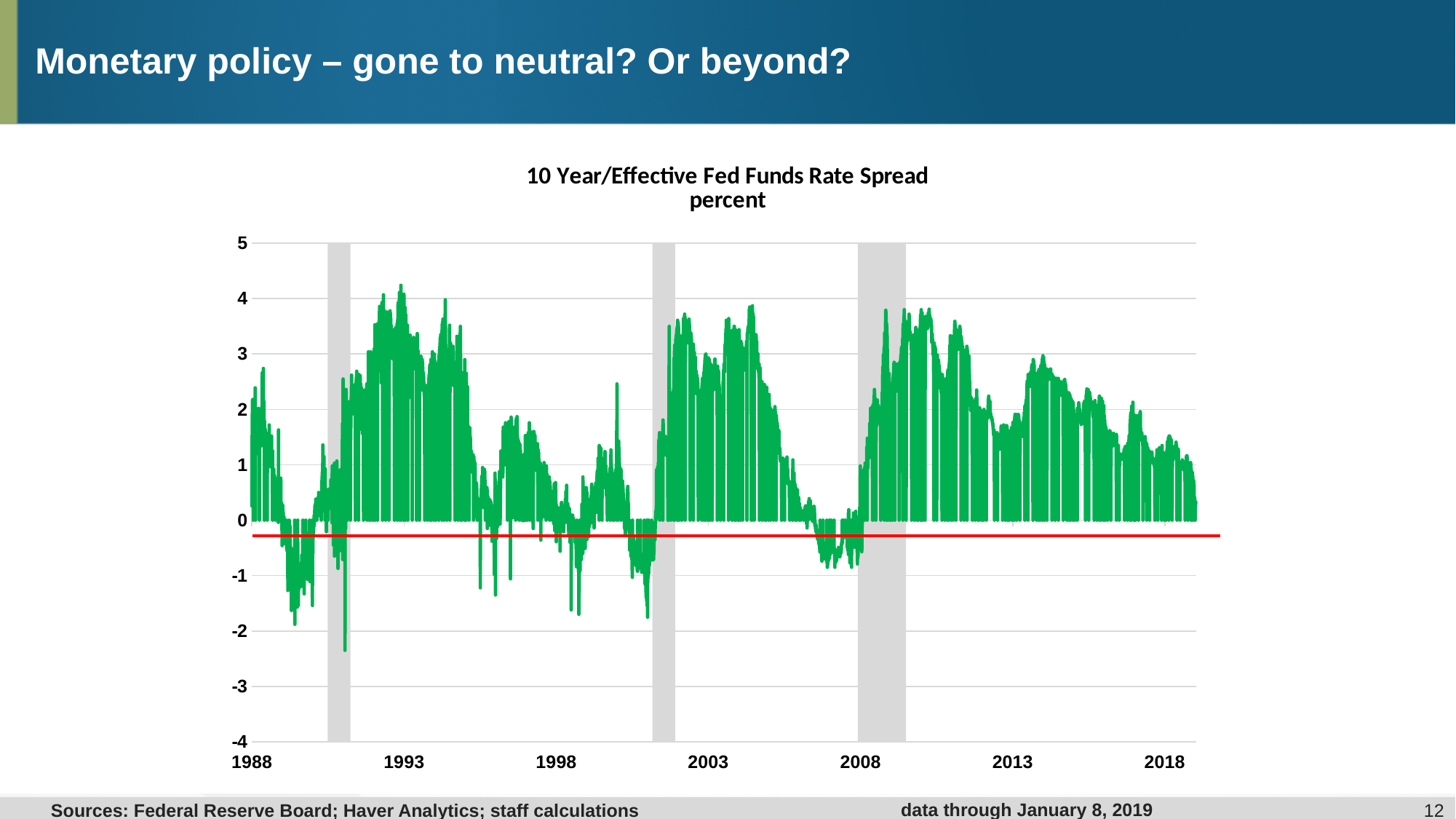
In what unit is the spread measured, according to the chart subtitle? percent How many year labels appear on the horizontal axis? 7 What is the last year labelled on the horizontal axis? 2018 Is the spread at the end of 2018 greater or less than 2? less What is the lowest value shown on the vertical axis? -4 Is the spread during 2007 greater or less than 0? less Is the peak value of the spread around 1992 greater or less than 3? greater What is the first year labelled on the horizontal axis? 1988 What is the title of the chart? 10 Year/Effective Fed Funds Rate Spread How many grey shaded bands are shown on the chart? 3 From around 2010 to 2018, does the spread generally rise or fall? fall